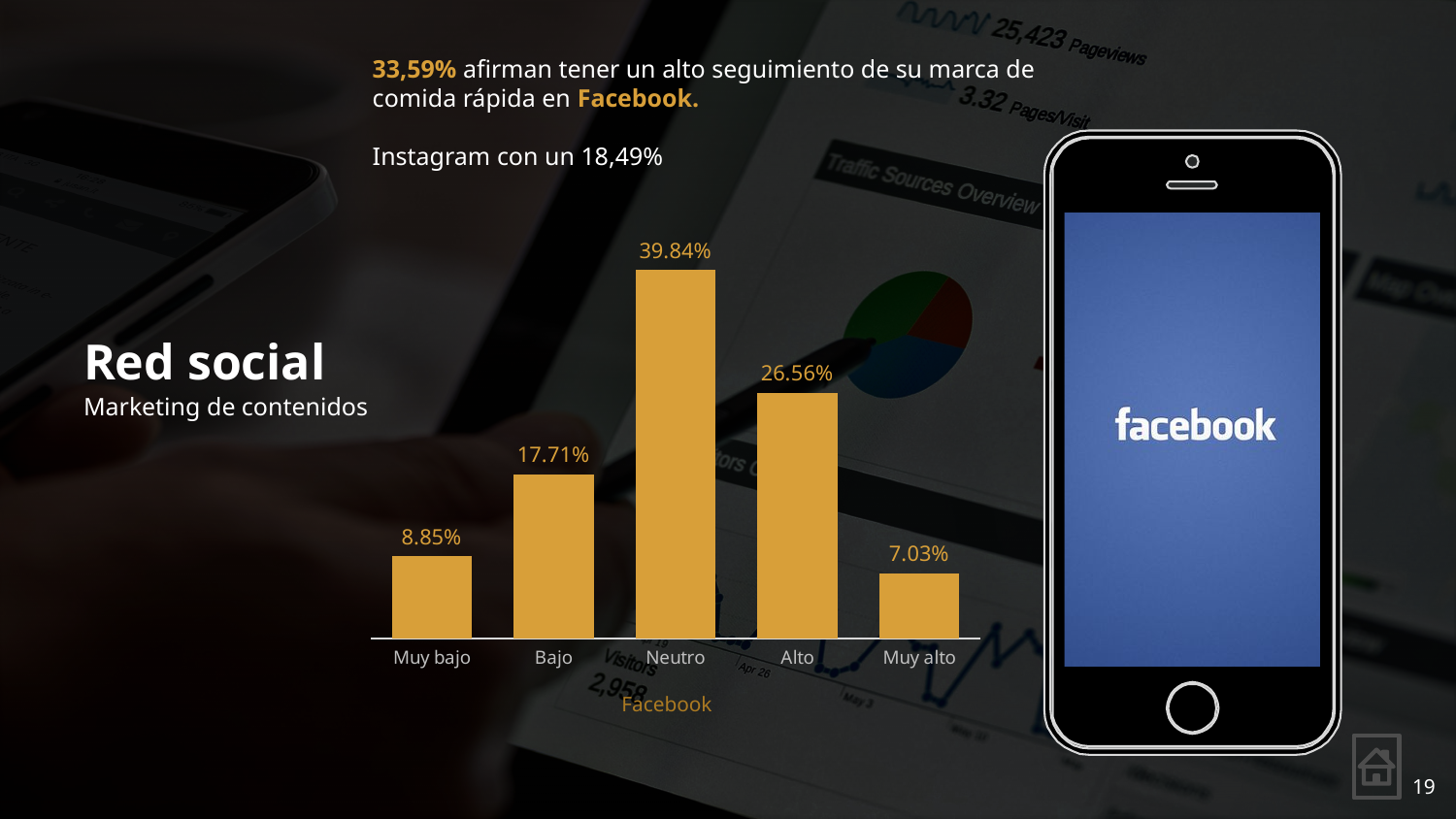
How many categories are shown in the Facebook chart? 5 What is the title shown below the chart's x axis? Facebook What kind of chart is shown on the slide? Bar chart What is the difference between the values for Bajo and Muy bajo in the Facebook chart? 8.86% What is the difference between the values for Neutro and Alto in the Facebook chart? 13.28% What is the value for Alto in the Facebook chart? 26.56% What is the value for Muy alto in the Facebook chart? 7.03% Which category has the lowest value in the Facebook chart? Muy alto Which is larger in the Facebook chart, the value for Bajo or the value for Alto? Alto What is the value for Muy bajo in the Facebook chart? 8.85% Which category has the highest value in the Facebook chart? Neutro What is the value for Neutro in the Facebook chart? 39.84%